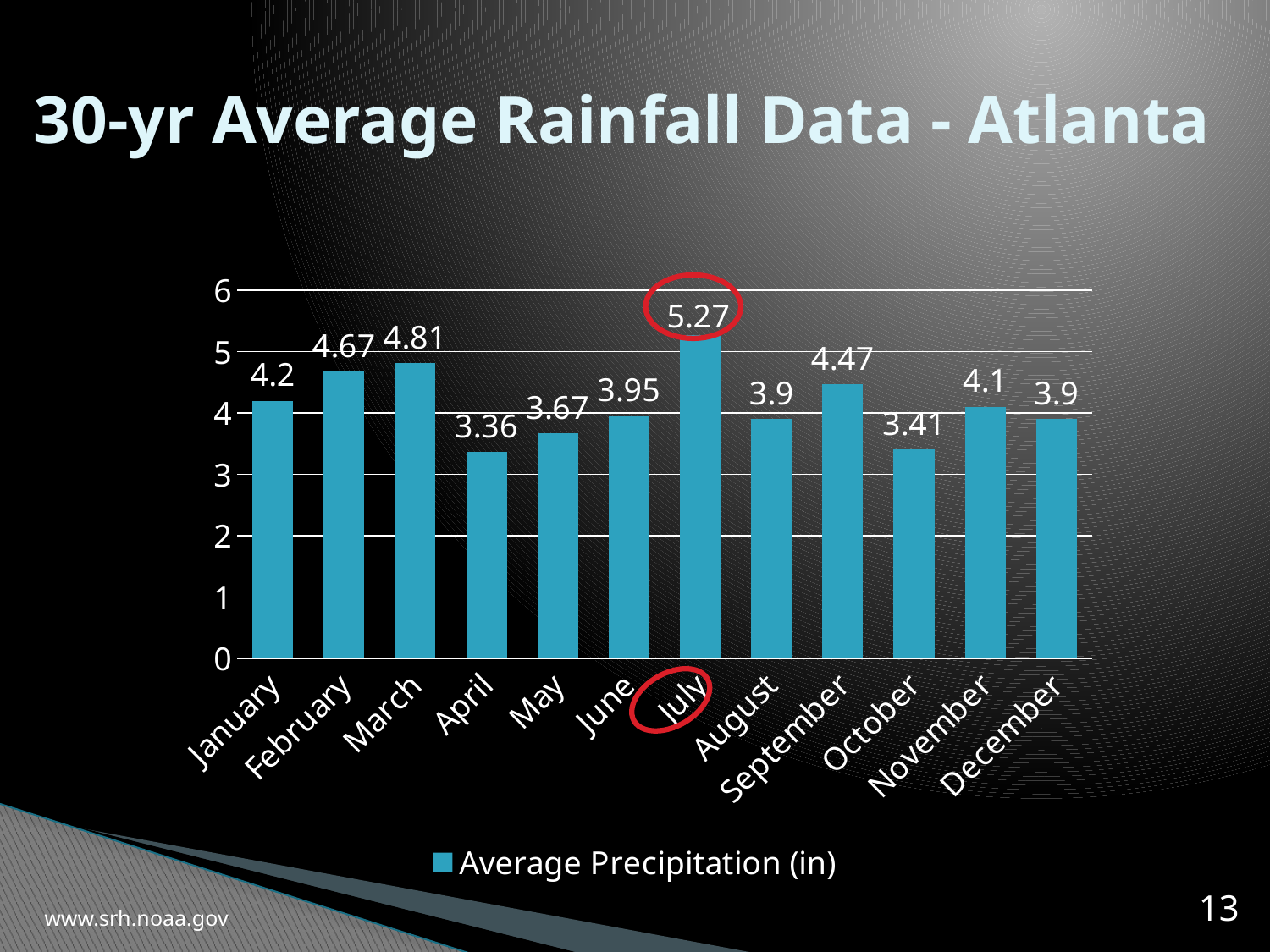
How many series does the legend list? 1 What is the legend entry for the series shown? Average Precipitation (in) What is the average precipitation for November? 4.1 Which month has the highest average precipitation? July What is the difference between the average precipitation for July and for April? 1.91 Which month has the lowest average precipitation? April Which month has higher average precipitation, March or September? March Is the value for October greater or less than 4? less What is the average precipitation for July? 5.27 How many months are shown on the x axis? 12 What is the average precipitation for April? 3.36 What kind of chart is shown on the slide? bar chart